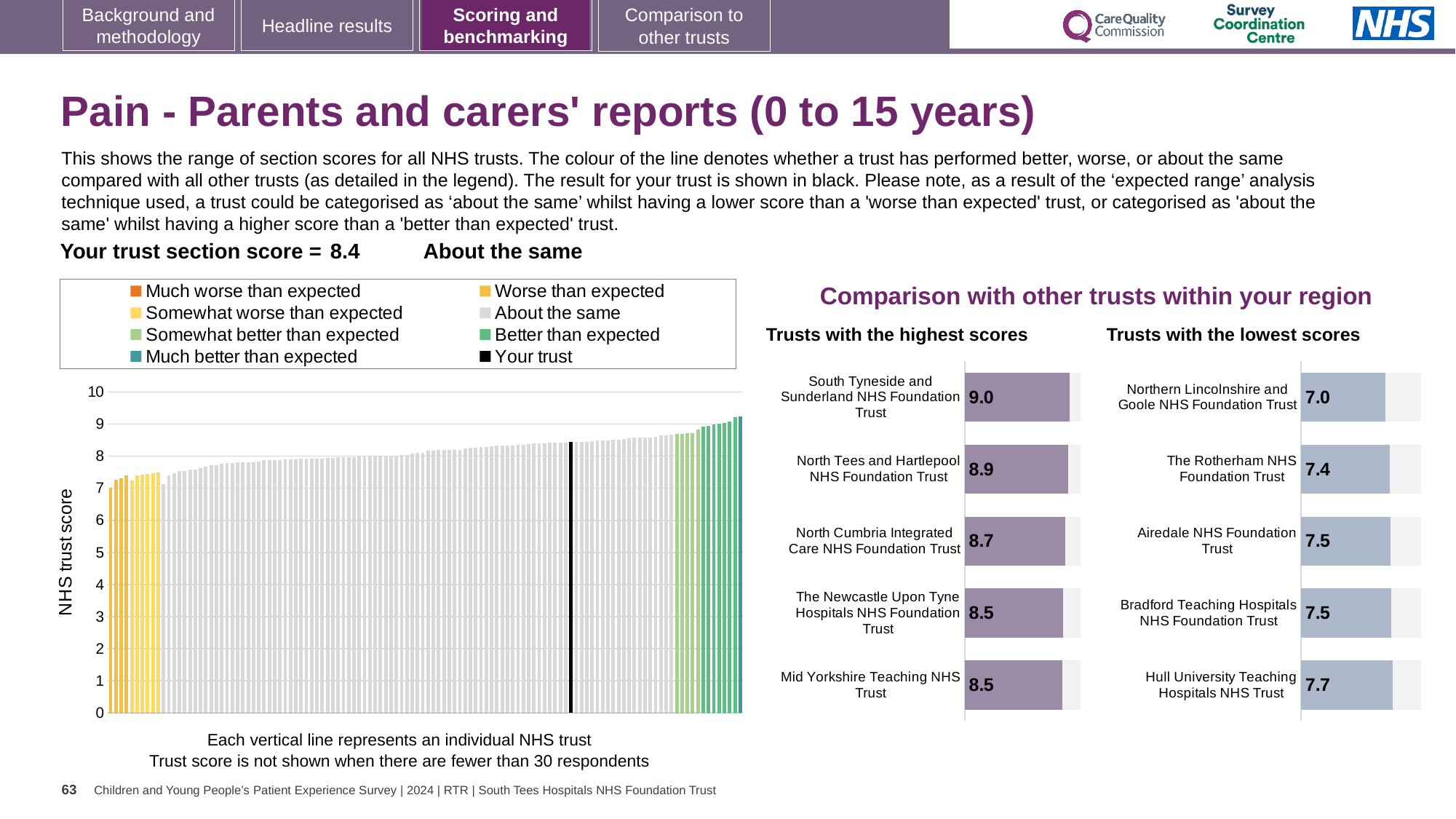
In the 'Trusts with the highest scores' chart, what is the difference between the scores of South Tyneside and Sunderland NHS Foundation Trust and North Tees and Hartlepool NHS Foundation Trust? 0.1 How many trusts are listed in the 'Trusts with the highest scores' chart? 5 What kind of chart is the main chart on the left with the 'NHS trust score' axis? bar chart In the main chart on the left, is the value for the black 'Your trust' bar greater or less than 8? greater In the 'Trusts with the highest scores' chart, what is the score for South Tyneside and Sunderland NHS Foundation Trust? 9.0 In the 'Trusts with the lowest scores' chart, what is the score for The Rotherham NHS Foundation Trust? 7.4 In the 'Trusts with the highest scores' chart, what is the score for North Cumbria Integrated Care NHS Foundation Trust? 8.7 In the 'Trusts with the lowest scores' chart, which has the larger score: The Rotherham NHS Foundation Trust or Hull University Teaching Hospitals NHS Trust? Hull University Teaching Hospitals NHS Trust In the 'Trusts with the lowest scores' chart, what is the difference between the scores of Hull University Teaching Hospitals NHS Trust and Northern Lincolnshire and Goole NHS Foundation Trust? 0.7 What is the section score for your trust shown on the slide? 8.4 In the 'Trusts with the lowest scores' chart, which trust has the lowest score? Northern Lincolnshire and Goole NHS Foundation Trust In the 'Trusts with the highest scores' chart, which trust has the highest score? South Tyneside and Sunderland NHS Foundation Trust